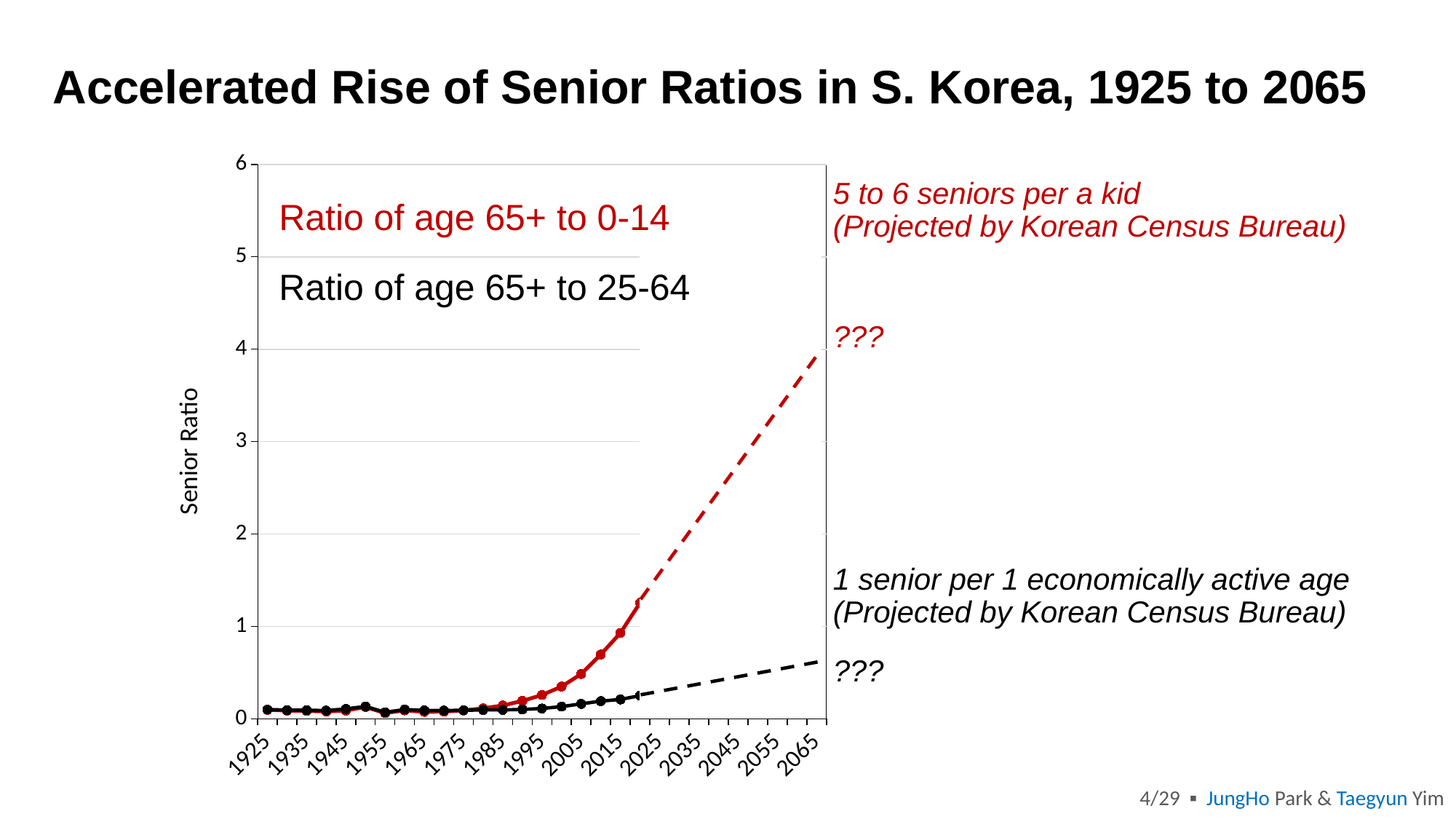
What is the title of the slide's chart? Accelerated Rise of Senior Ratios in S. Korea, 1925 to 2065 In 2065, which series has the larger value: Ratio of age 65+ to 0-14 or Ratio of age 65+ to 25-64? Ratio of age 65+ to 0-14 Is the value of the Ratio of age 65+ to 25-64 in 2065 greater or less than 1? less Is the value of the Ratio of age 65+ to 0-14 in 2005 greater or less than 1? less Does the Ratio of age 65+ to 0-14 rise or fall from 1985 to 2065? rise What is the label on the vertical axis? Senior Ratio How many year labels are shown on the x axis? 15 Is the value of the Ratio of age 65+ to 0-14 in 2065 greater or less than 3? greater Which series is drawn in red? Ratio of age 65+ to 0-14 What kind of chart is shown on the slide? line chart How many series are plotted on the chart? 2